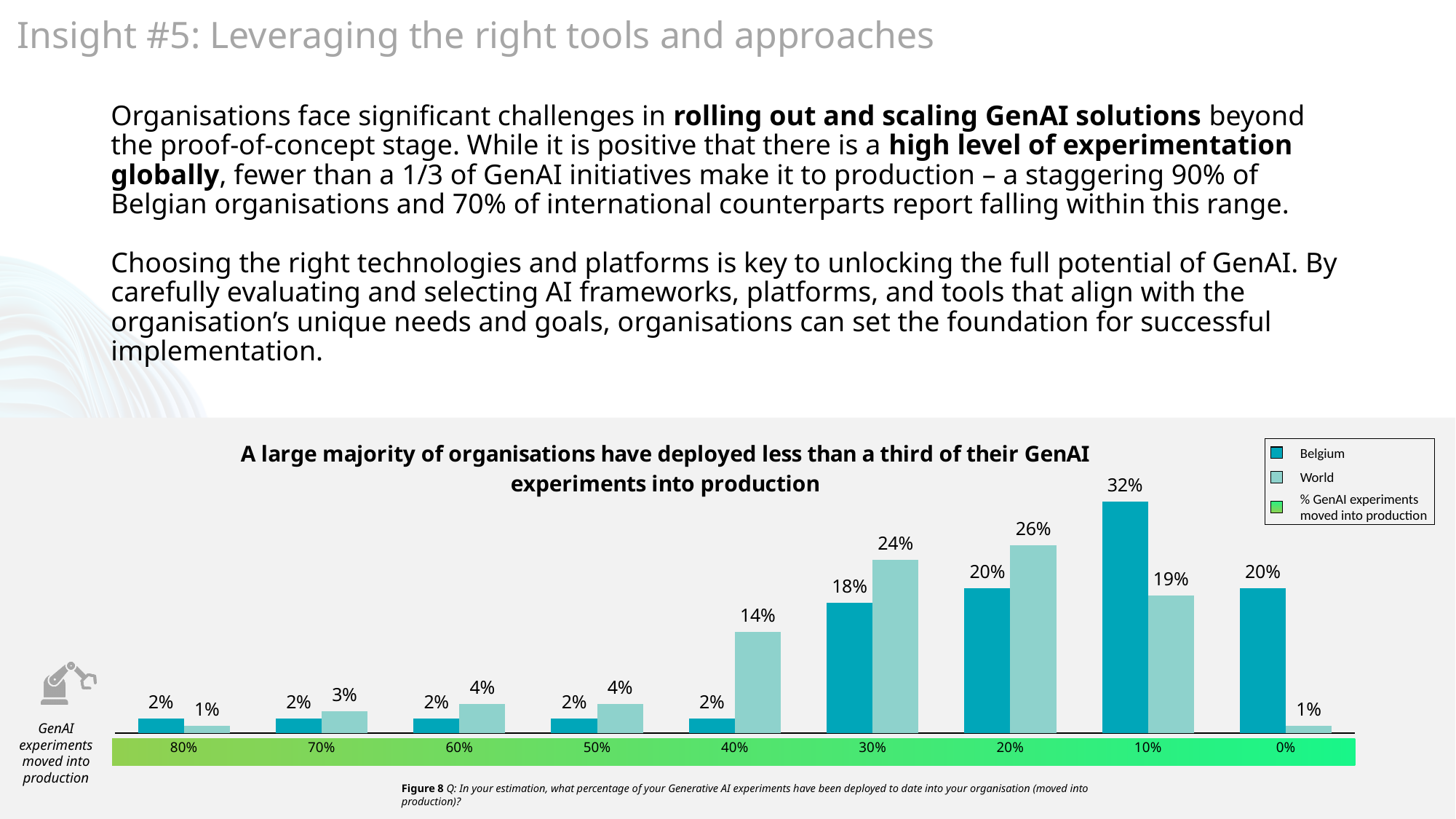
How many categories are shown on the x axis? 9 What is the World value for the 0% category? 1% For the 20% category, which is larger, the Belgium value or the World value? World What is the difference between the World and Belgium values for the 30% category? 6% Which category has the highest World value? 20% How many entries does the chart legend list? 3 Which category has the lowest World value? 80% and 0% (both 1%) What type of chart is shown on the slide? Bar chart What is the Belgium value for the 10% category? 32% What is the difference between the Belgium and World values for the 10% category? 13% What is the World value for the 40% category? 14% Which category has the highest Belgium value? 10%